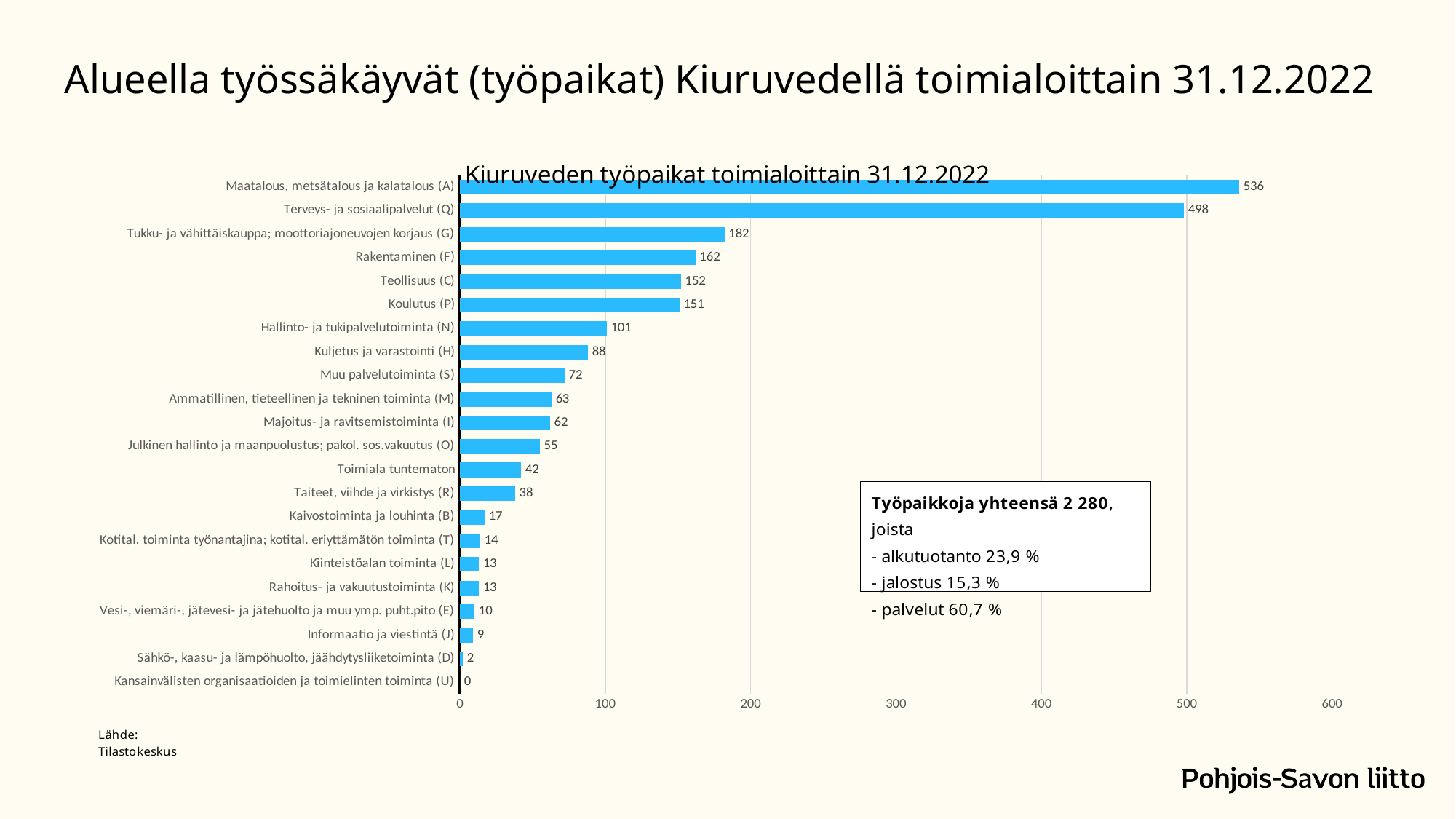
Is the value for Tukku- ja vähittäiskauppa; moottoriajoneuvojen korjaus (G) greater or less than 200? less What is the value for Taiteet, viihde ja virkistys (R)? 38 What is the value for Kuljetus ja varastointi (H)? 88 Which category has the lowest value? Kansainvälisten organisaatioiden ja toimielinten toiminta (U) What is the value for Terveys- ja sosiaalipalvelut (Q)? 498 Which is larger, Teollisuus (C) or Hallinto- ja tukipalvelutoiminta (N)? Teollisuus (C) How many categories are shown in the chart? 22 Which category has the highest value? Maatalous, metsätalous ja kalatalous (A) What kind of chart is shown on the slide? bar chart What is the difference between Maatalous, metsätalous ja kalatalous (A) and Terveys- ja sosiaalipalvelut (Q)? 38 What is the title of the chart? Kiuruveden työpaikat toimialoittain 31.12.2022 What is the value for Rakentaminen (F)? 162